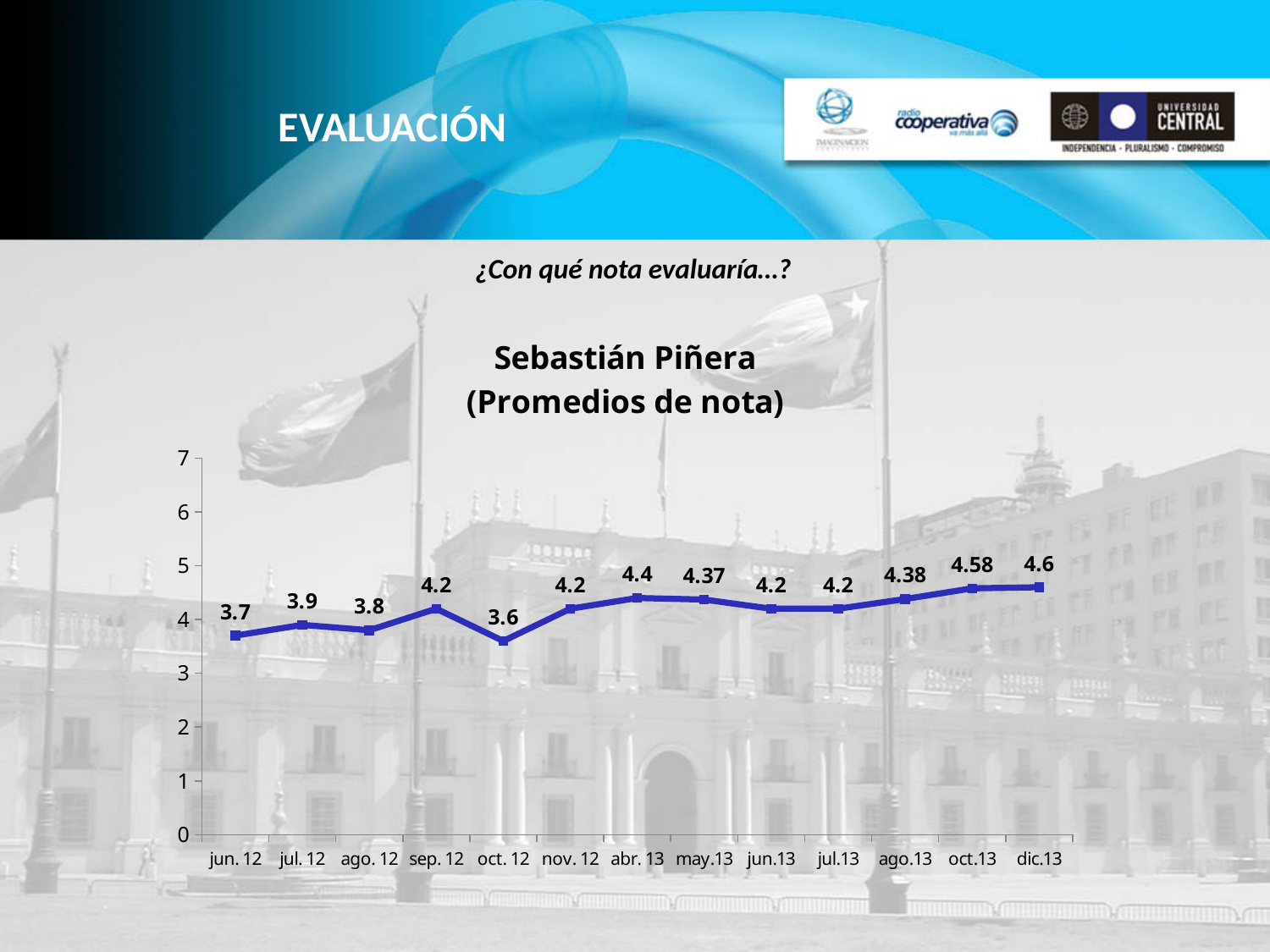
Which is larger, the value for abr. 13 or the value for ago.13? abr. 13 Does the value rise or fall from ago.13 to dic.13? rise How many months are plotted on the x axis? 13 Which month has the highest average grade on the chart? dic.13 What is the difference between the values for dic.13 and jun. 12? 0.9 Which month has the lowest average grade on the chart? oct. 12 What is the value plotted for oct.13? 4.58 What kind of chart is shown on the slide? line chart What is the title of the chart? Sebastián Piñera (Promedios de nota) Is the value for oct. 12 greater or less than 4? less What is the average grade for Sebastián Piñera in jun. 12? 3.7 What is the value plotted for may.13? 4.37